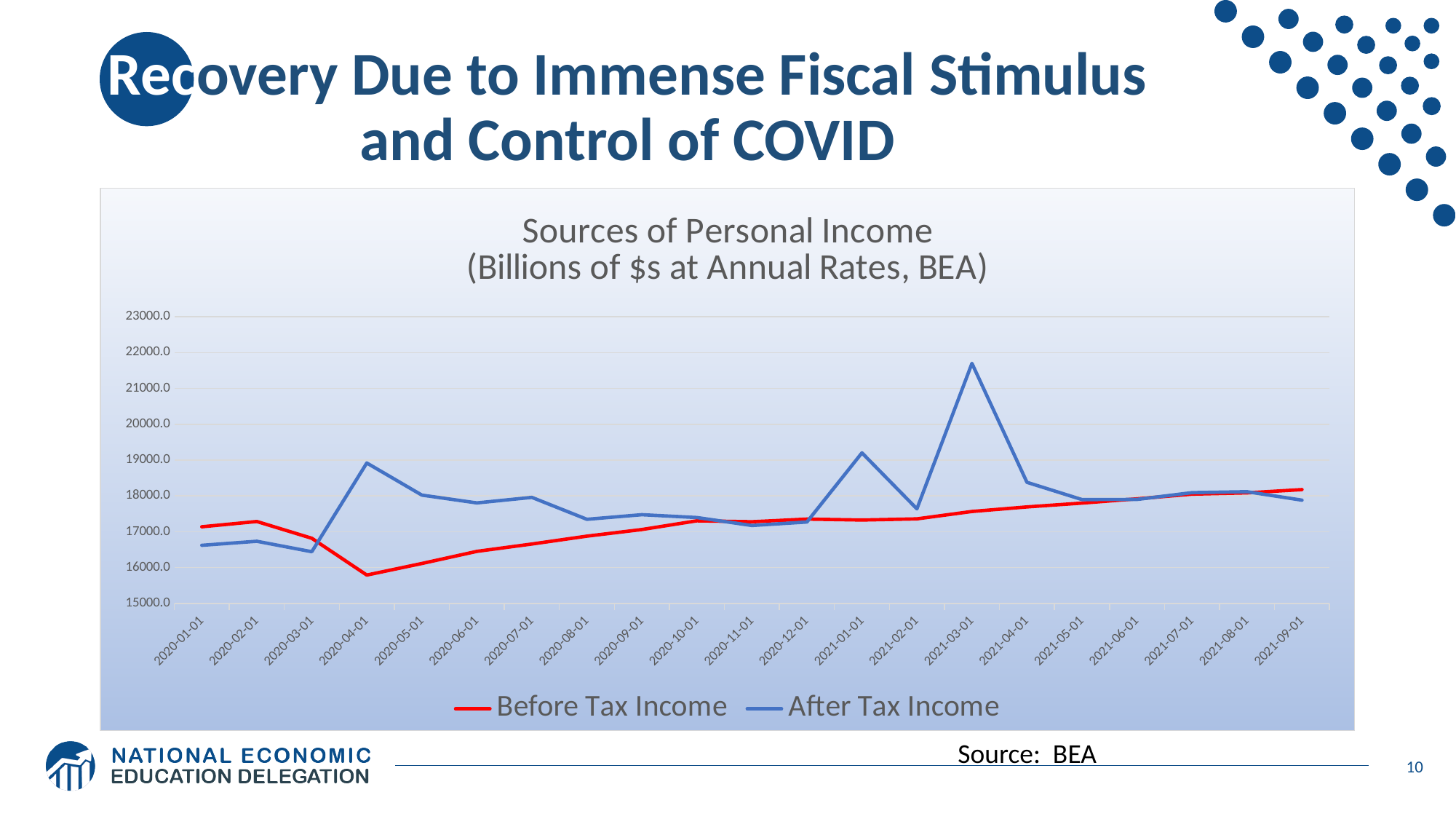
Is the value of After Tax Income at 2021-03-01 greater or less than 21000.0? greater Does Before Tax Income generally rise or fall from 2020-04-01 to 2021-09-01? Rise How many dates are plotted along the x axis? 21 Is the value of After Tax Income at 2020-04-01 greater or less than 18000.0? greater At which date does After Tax Income reach its highest value? 2021-03-01 At 2020-01-01, which series has the higher value, Before Tax Income or After Tax Income? Before Tax Income At which date does Before Tax Income reach its lowest value? 2020-04-01 How many series does the legend list? 2 At 2020-04-01, which series has the higher value, Before Tax Income or After Tax Income? After Tax Income What kind of chart is shown on the slide? Line chart Is the value of Before Tax Income at 2020-04-01 greater or less than 16000.0? less What colour is the line for After Tax Income? Blue